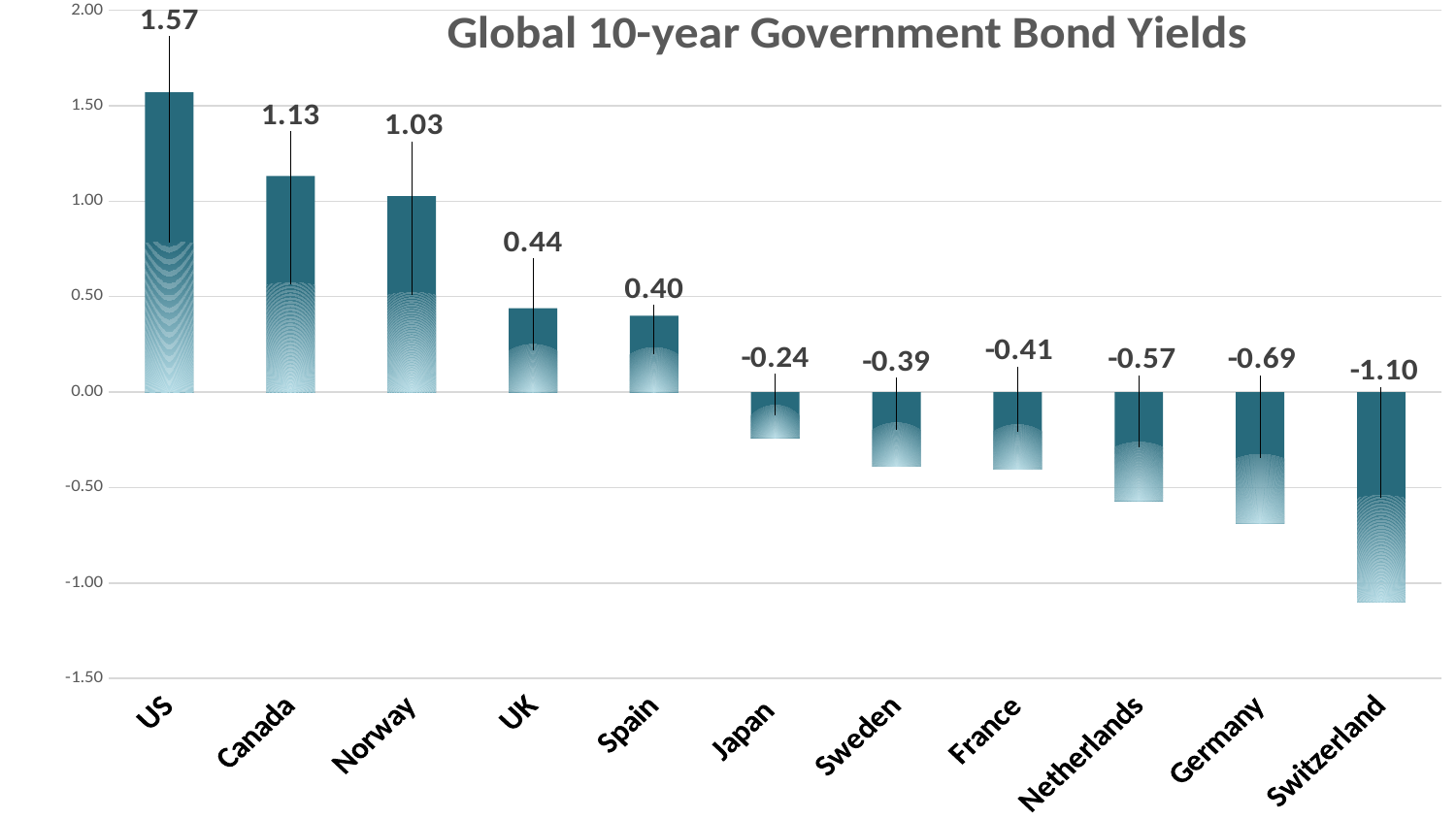
What is the value shown for Germany? -0.69 Which country has the highest bond yield on the chart? US What kind of chart is this? Bar chart What is the difference between the values for Canada and Norway? 0.10 What is the difference between the values for the UK and Spain? 0.04 Which country has the lowest bond yield on the chart? Switzerland What is the value shown for Japan? -0.24 Do the values rise or fall moving from left to right along the x axis? Fall How many countries are shown on the chart? 11 Which has a higher value, Sweden or France? Sweden What is the 10-year government bond yield shown for the US? 1.57 What is the title of the chart? Global 10-year Government Bond Yields